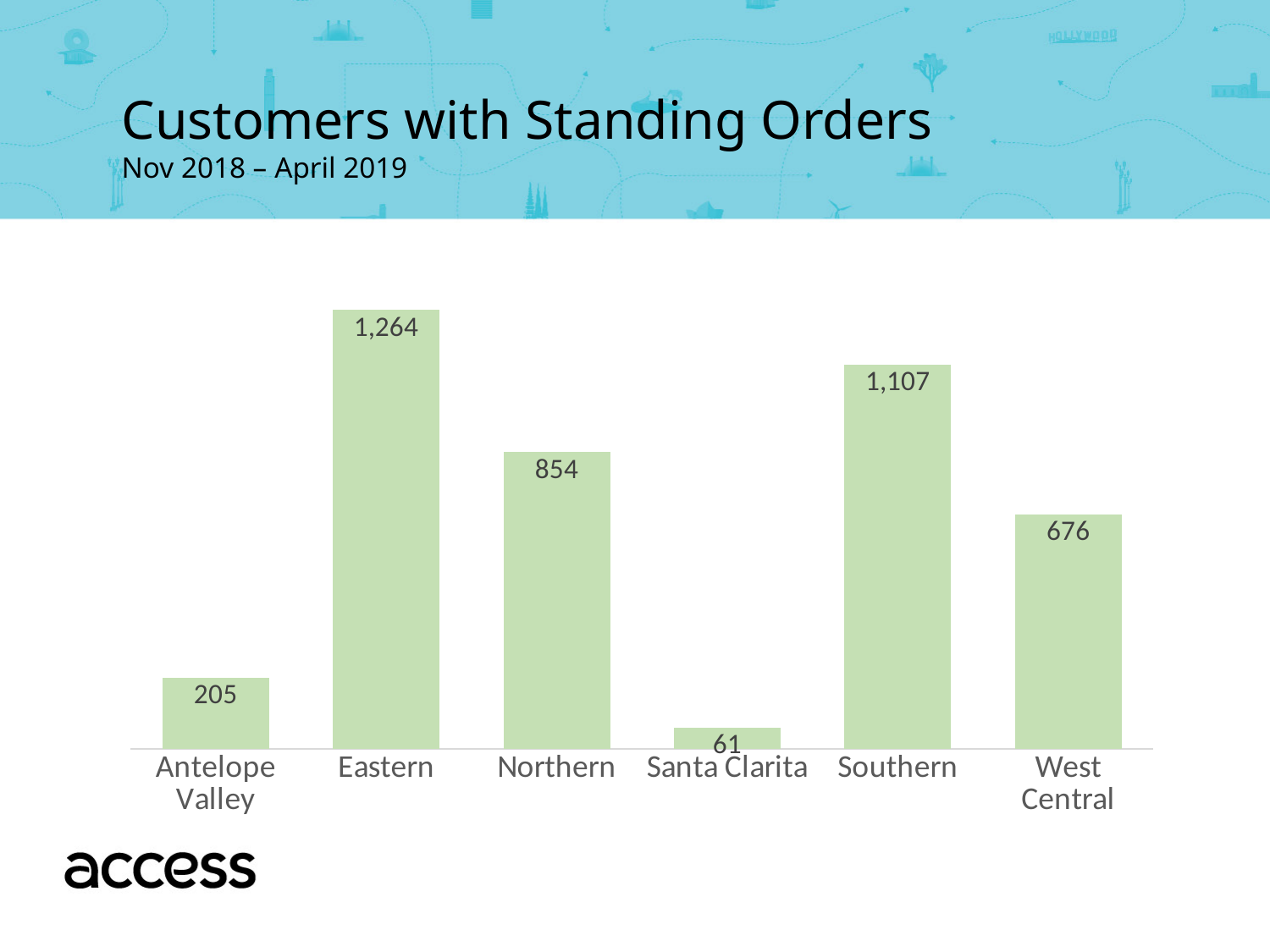
How many regions are shown on the chart? 6 What is the difference between the values for Eastern and Southern? 157 What kind of chart is shown on the slide? Bar chart What time period does the chart subtitle give? Nov 2018 – April 2019 What is the value for Santa Clarita? 61 What is the value for West Central? 676 What is the difference between the values for Northern and West Central? 178 What is the value for Eastern? 1,264 What is the value for Antelope Valley? 205 Which region has the highest number of customers with standing orders? Eastern Which is larger, the value for Northern or the value for Southern? Southern Which region has the lowest number of customers with standing orders? Santa Clarita